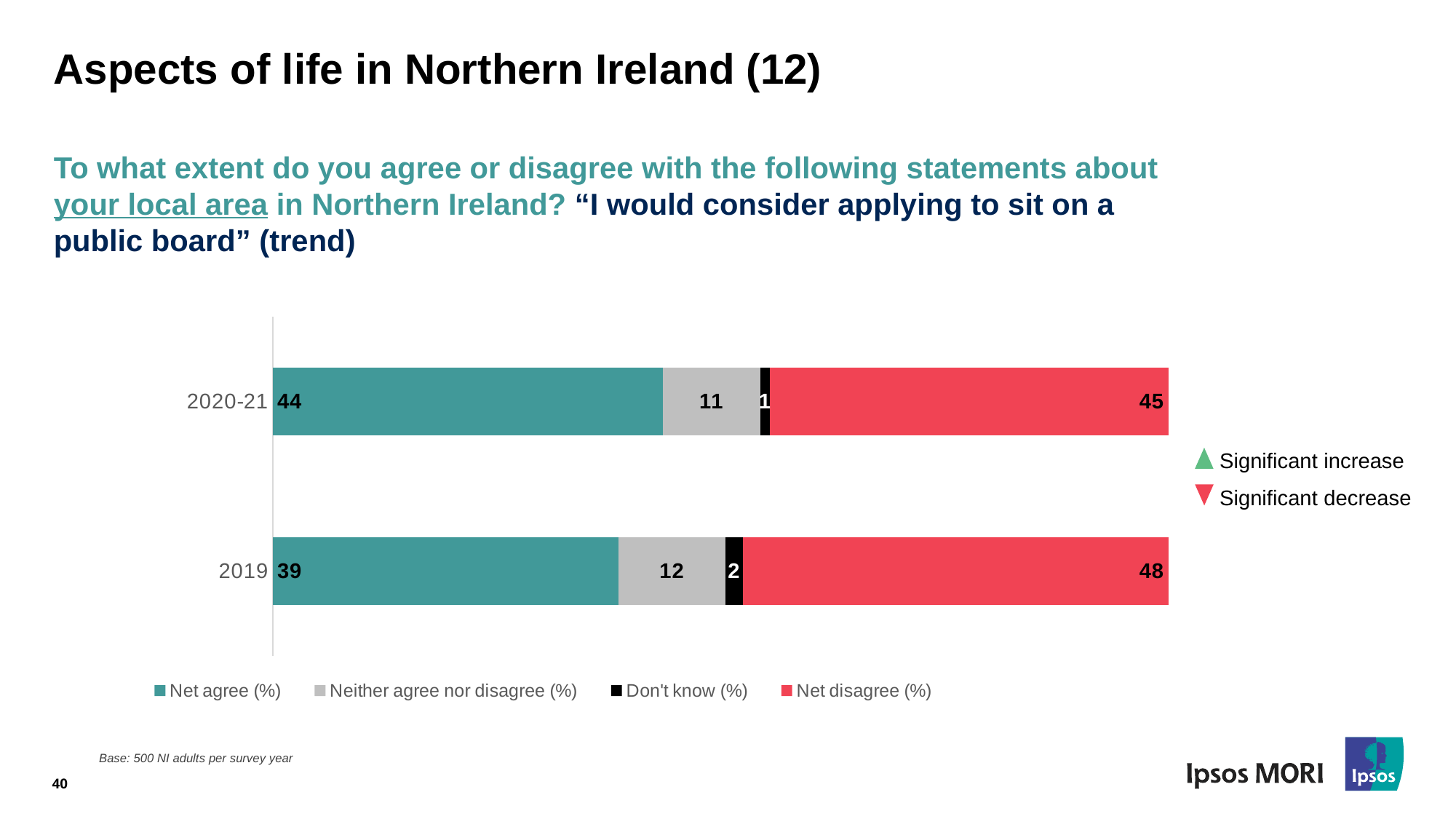
How many series does the chart legend list? 4 What is the Net agree (%) value for 2020-21? 44 Which year has the higher Net agree (%) value? 2020-21 Which year has the lower Net disagree (%) value? 2020-21 What is the Neither agree nor disagree (%) value for 2020-21? 11 What kind of chart is shown on the slide? stacked bar chart How many years are shown in the chart? 2 Is the Net disagree (%) value for 2019 larger or smaller than the Net disagree (%) value for 2020-21? larger What is the total of the stacked bar for 2019? 101 What is the Net disagree (%) value for 2019? 48 What is the Don't know (%) value for 2019? 2 What is the difference between the Net agree (%) values for 2020-21 and 2019? 5